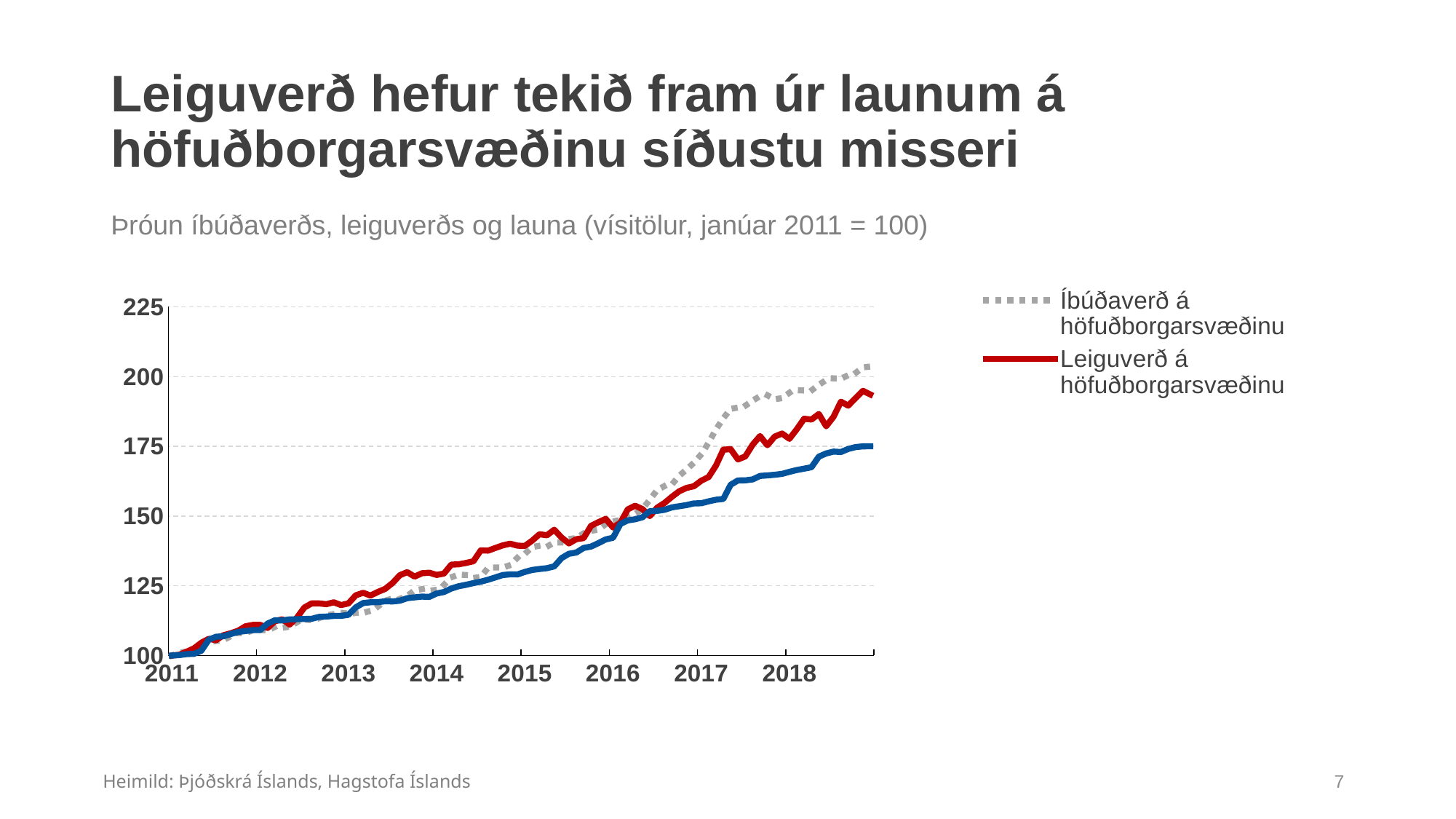
Does the Íbúðaverð á höfuðborgarsvæðinu line rise or fall from 2011 to 2018? rise Is the value of Leiguverð á höfuðborgarsvæðinu at the start of 2017 greater or less than 150? greater What is the index value of the series in January 2011, according to the chart subtitle? 100 Is the final value of Leiguverð á höfuðborgarsvæðinu greater or less than 200? less Is the final value of Íbúðaverð á höfuðborgarsvæðinu greater or less than 200? greater Does the Leiguverð á höfuðborgarsvæðinu line rise or fall from 2011 to 2018? rise How many year labels are shown on the x axis? 8 What kind of chart is shown on the slide? line chart What colour is the Leiguverð á höfuðborgarsvæðinu line? red How many series does the legend list? 2 At the end of the series (late 2018), which is higher, Íbúðaverð á höfuðborgarsvæðinu or Leiguverð á höfuðborgarsvæðinu? Íbúðaverð á höfuðborgarsvæðinu